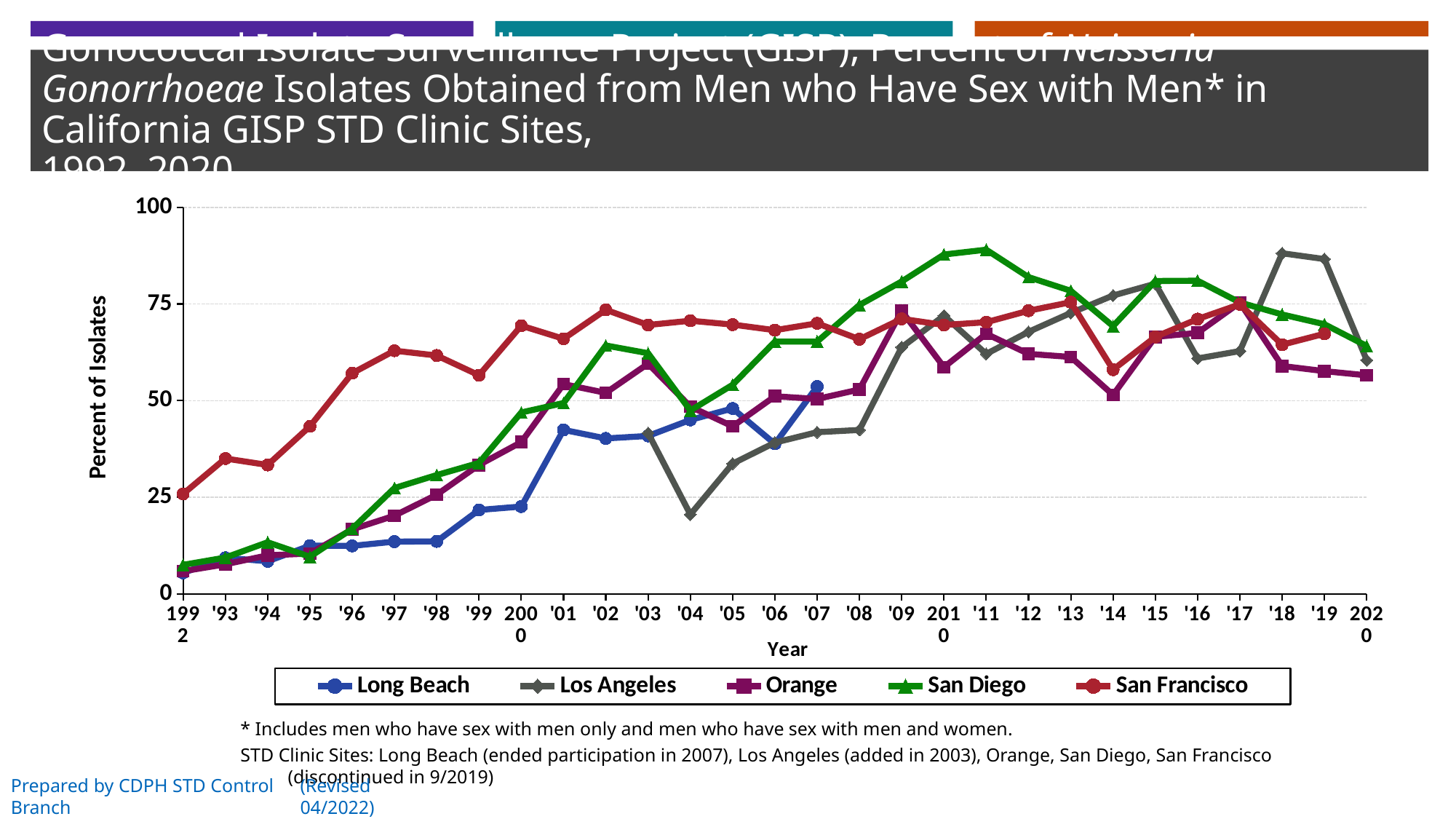
Is the value for Long Beach in 1992 greater or less than 25? less What is the title of the y axis? Percent of Isolates Which series has the highest value in 2011? San Diego Is the value for Los Angeles in 2004 greater or less than 50? less How many series does the legend list? 5 Is the value for San Diego in 2011 greater or less than 75? greater In 2018, which is larger: the value for Los Angeles or the value for Orange? Los Angeles What kind of chart is shown on the slide? line chart Which series has the lowest value in 2004? Los Angeles Does the Long Beach series generally rise or fall from 1992 to 2007? rise Which series is drawn in green? San Diego